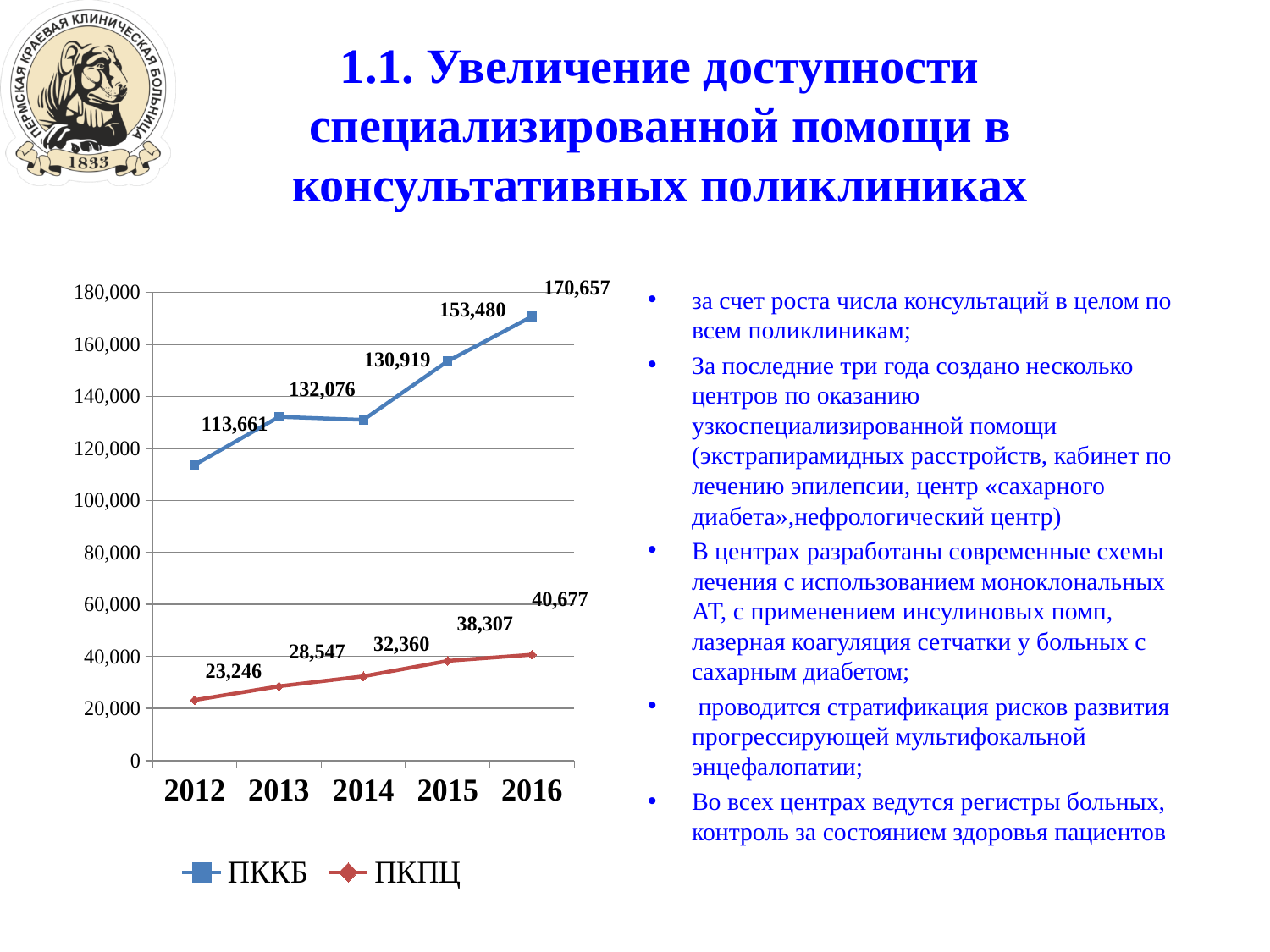
In which year is the ПККБ value highest? 2016 In which year is the ПКПЦ value lowest? 2012 What is the difference between the ПКПЦ values in 2016 and 2012? 17,431 Do the ПКПЦ values rise or fall from 2012 to 2016? rise How many series does the legend list? 2 What type of chart is shown on the slide? line chart What is the value for ПККБ in 2014? 130,919 What is the value for ПКПЦ in 2015? 38,307 By how much did the ПККБ value increase from 2012 to 2016? 56,996 How many years are plotted on the x axis? 5 What is the value for ПККБ in 2012? 113,661 Which is larger for ПККБ: the 2013 value or the 2014 value? 2013